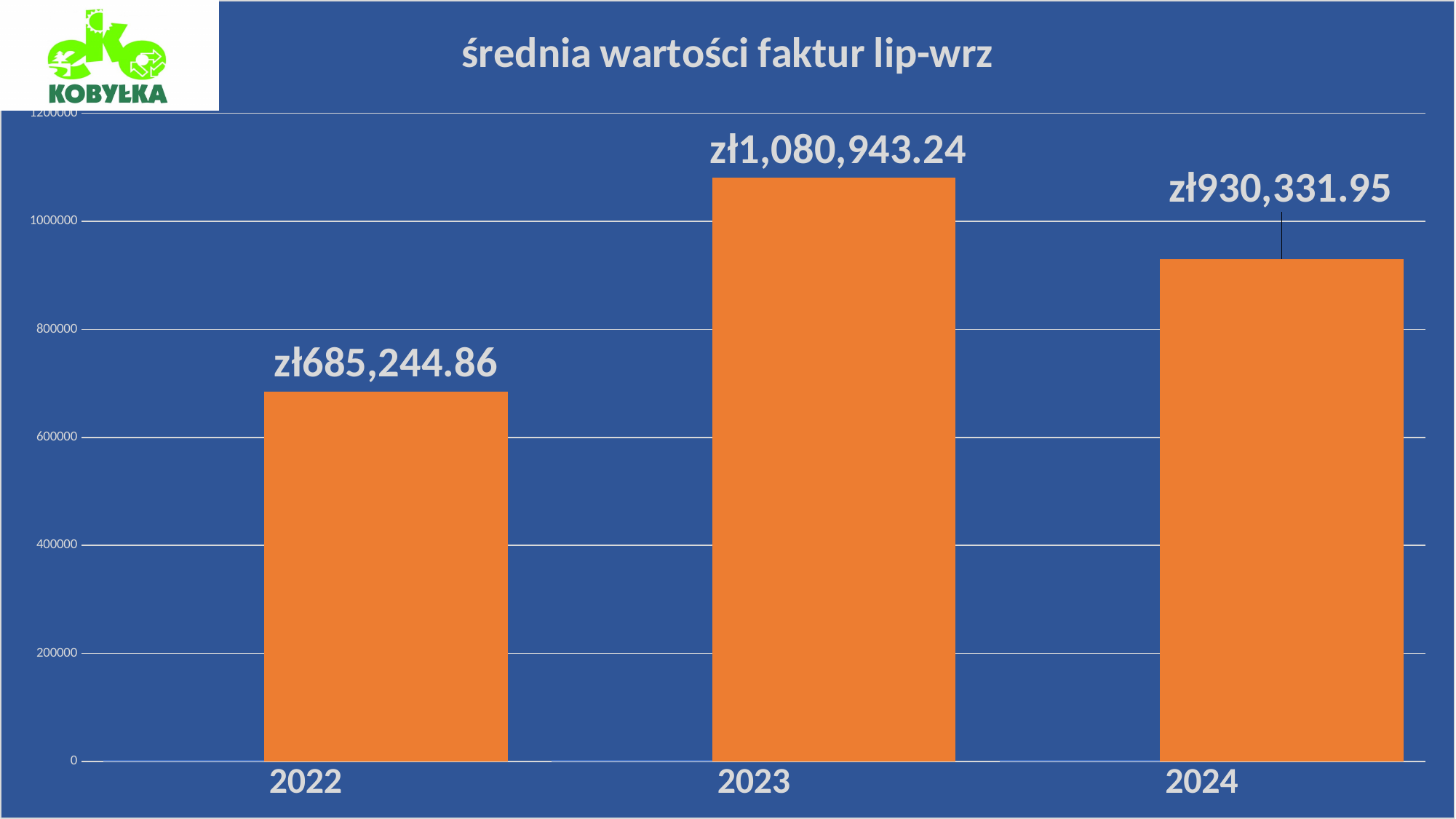
Is the value for 2022 greater or less than 800000? less Which year has the highest value? 2023 Which is larger, the value for 2024 or the value for 2022? 2024 What is the value for 2022? zł685,244.86 What is the value for 2023? zł1,080,943.24 What is the difference between the values for 2023 and 2022? zł395,698.38 What is the title of the chart? średnia wartości faktur lip-wrz What is the value for 2024? zł930,331.95 What kind of chart is shown on the slide? bar chart What is the difference between the values for 2023 and 2024? zł150,611.29 How many years are shown on the chart? 3 Which year has the lowest value? 2022